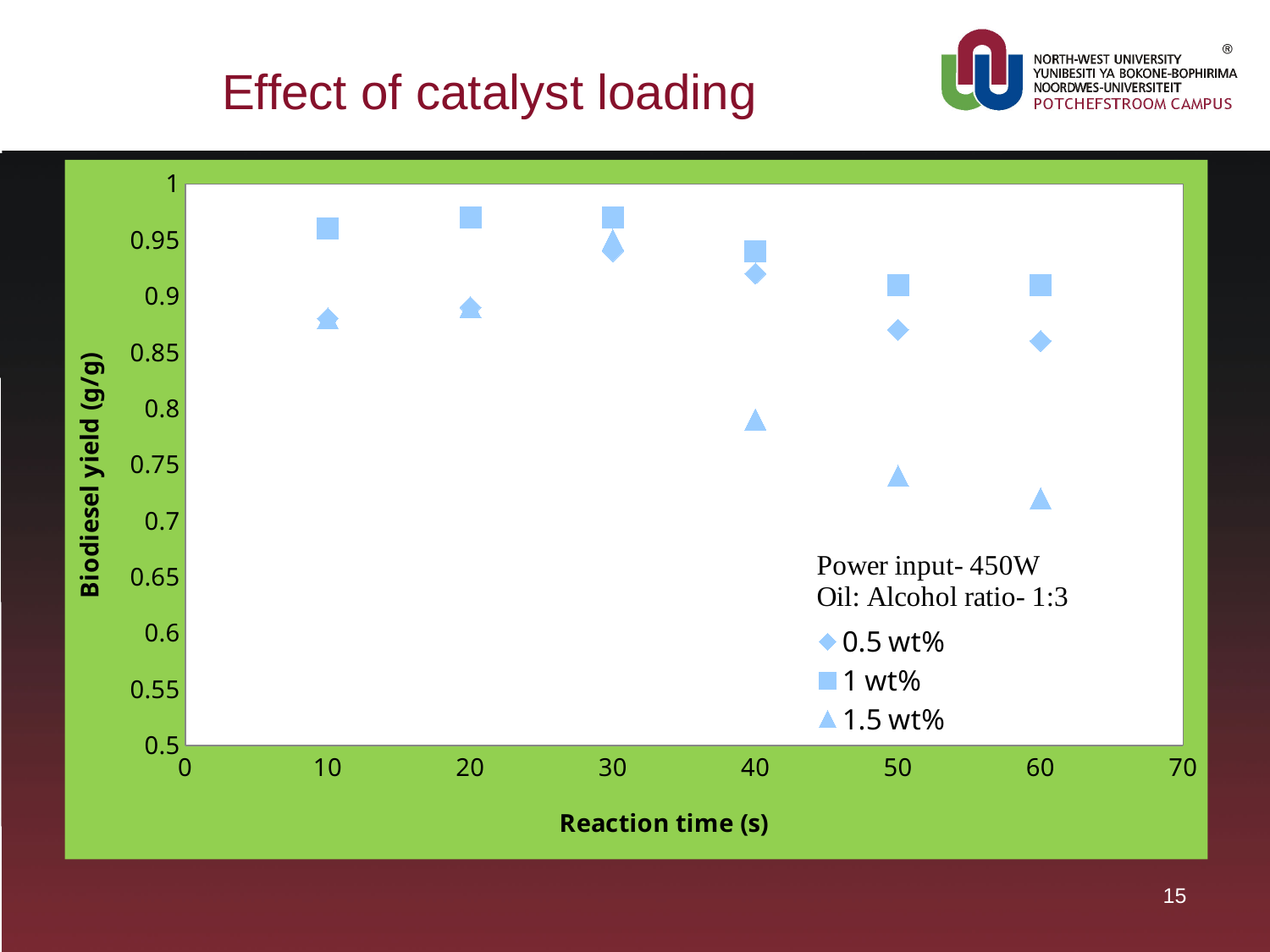
Which series has the lowest biodiesel yield at 40 s? 1.5 wt% Does the biodiesel yield for the 1.5 wt% series rise or fall from 30 s to 60 s? fall Is the biodiesel yield for 1.5 wt% at 60 s greater or less than 0.75? less How many data points are plotted for the 1.5 wt% series? 6 What is the title of the x axis? Reaction time (s) How many series does the legend list? 3 Which series has the highest biodiesel yield at 60 s? 1 wt% Is the biodiesel yield for 0.5 wt% at 60 s greater or less than 0.9? less Is the biodiesel yield for 1 wt% at 20 s greater or less than 0.95? greater At 60 s, which series has the higher biodiesel yield, 1 wt% or 1.5 wt%? 1 wt% What kind of chart is shown on the slide? Scatter chart